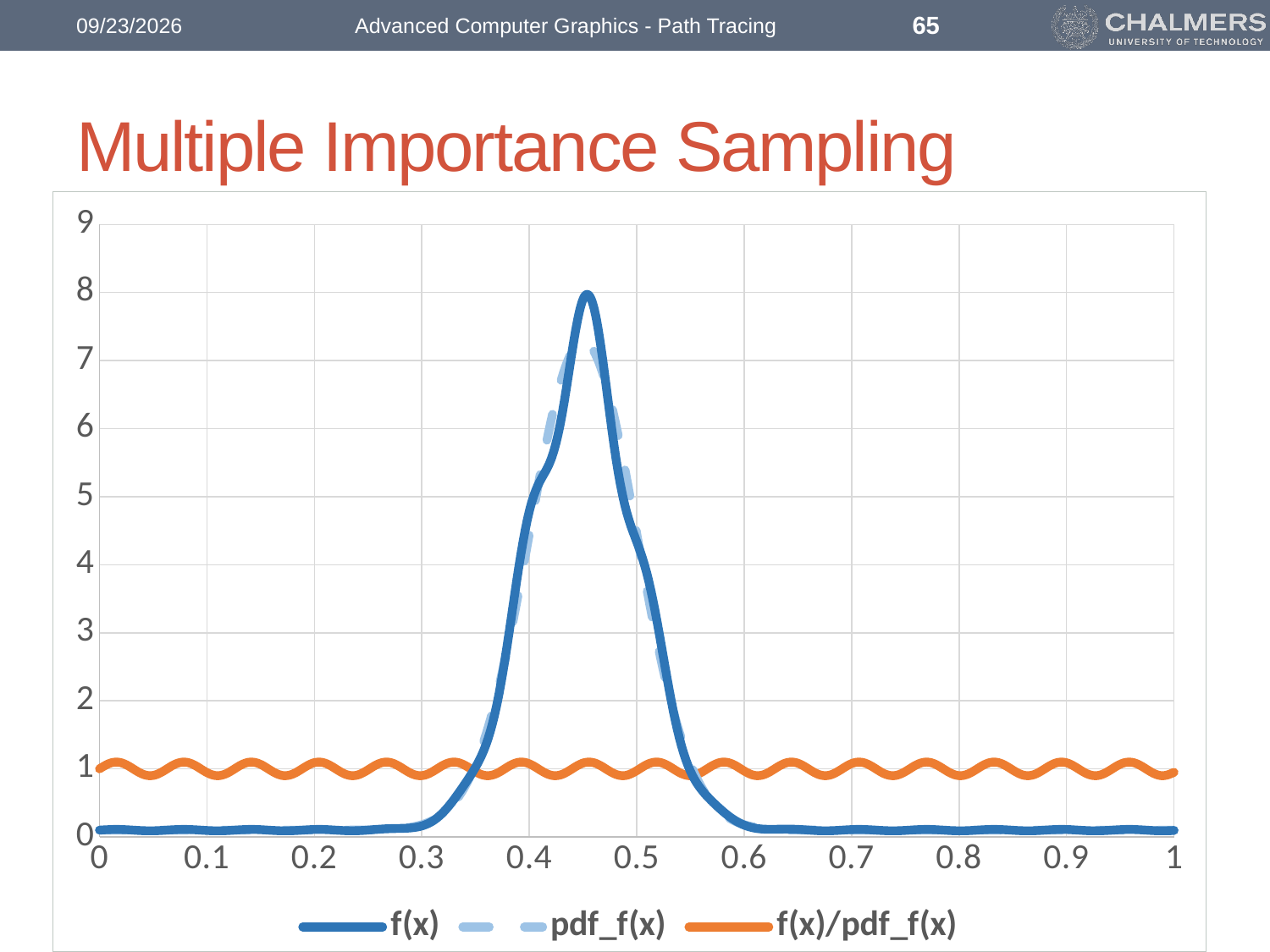
Is the value of f(x)/pdf_f(x) at x = 0.7 greater or less than 2? less Does f(x) rise or fall as x goes from 0.3 to 0.45? rise What is the highest value labelled on the vertical axis? 9 Which series is drawn with a dashed line? pdf_f(x) Which series are listed in the legend? f(x), pdf_f(x), f(x)/pdf_f(x) Does f(x) rise or fall as x goes from 0.5 to 0.6? fall Is the peak value of f(x) greater or less than 7? greater How many series does the legend list? 3 At x = 0.45, which is larger: f(x) or f(x)/pdf_f(x)? f(x) Is the value of f(x) at x = 0.4 greater or less than 3? greater What kind of chart is shown on the slide? line chart